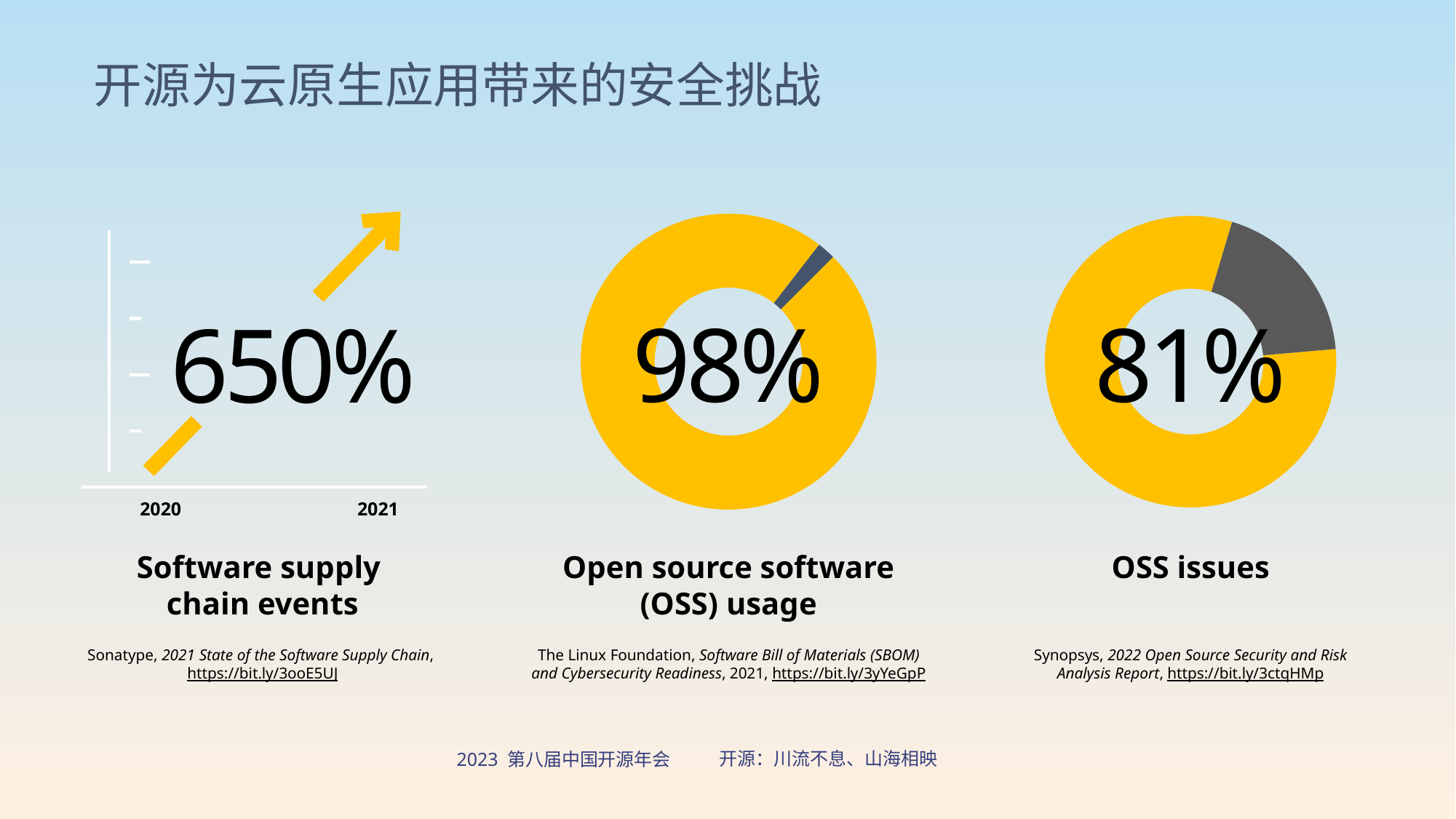
Which is larger: the percentage on the 'Open source software (OSS) usage' chart or the percentage on the 'OSS issues' chart? Open source software (OSS) usage (98%) On the 'Open source software (OSS) usage' donut chart, what share of the ring is the dark grey segment? 2% What colour is the main (largest) segment of the 'OSS issues' donut chart? Yellow What is the difference in percentage points between the 'Open source software (OSS) usage' value and the 'OSS issues' value? 17 percentage points On the 'OSS issues' donut chart, what percentage is shown in the centre? 81% On the 'Open source software (OSS) usage' donut chart, what percentage is shown in the centre? 98% Which organisation is cited as the source for the 'OSS issues' chart? Synopsys How many years are labelled on the x axis of the 'Software supply chain events' chart? 2 On the 'Software supply chain events' chart, what percentage figure is displayed? 650% On the 'OSS issues' donut chart, what share of the ring is the grey segment? 19% On the 'Software supply chain events' chart, do the values rise or fall from 2020 to 2021? Rise What kind of chart is used for 'Open source software (OSS) usage'? Donut (pie) chart